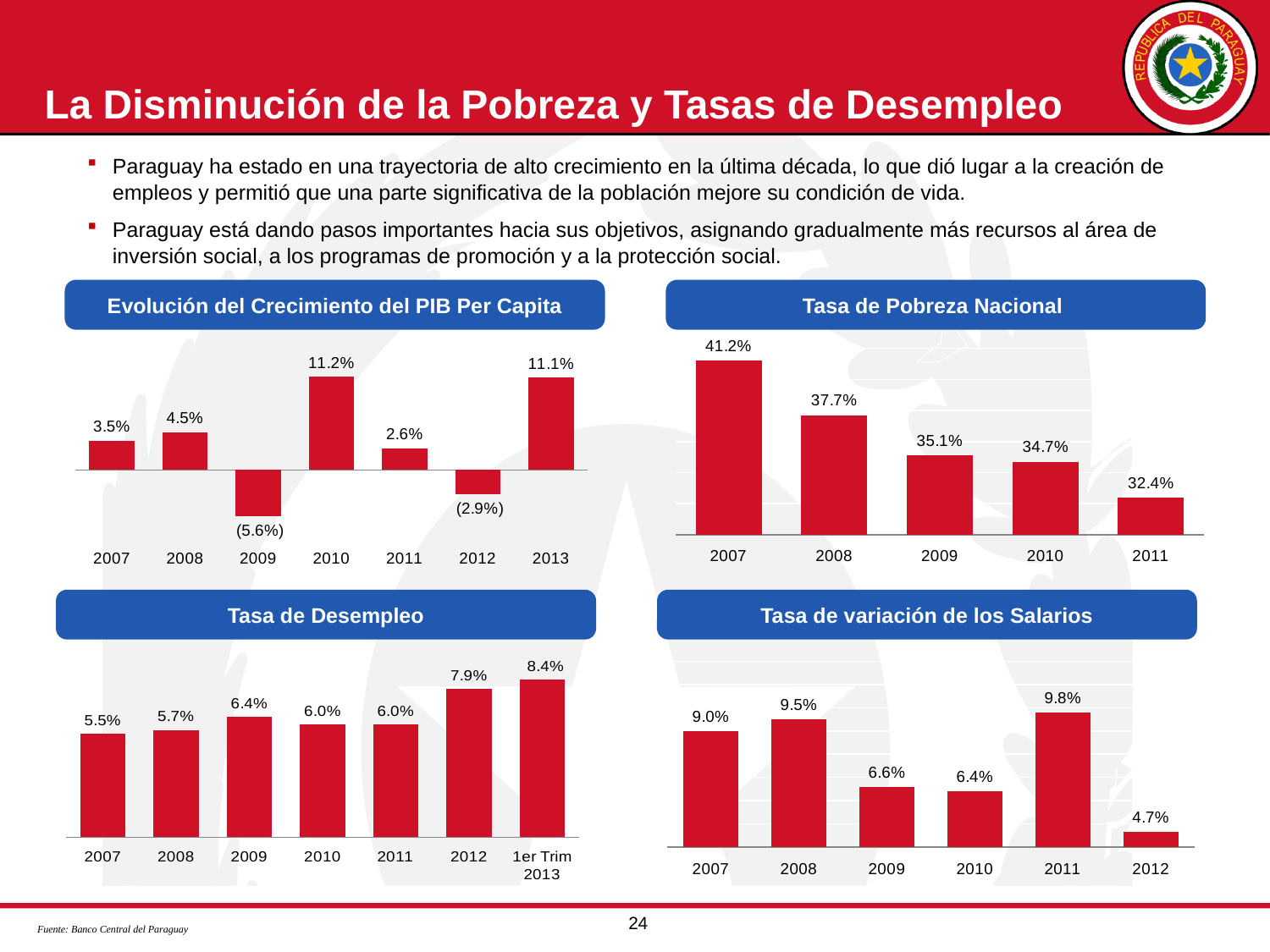
In the 'Tasa de Pobreza Nacional' chart, what is the difference between the 2007 and 2008 values? 3.5% In the 'Evolución del Crecimiento del PIB Per Capita' chart, what is the value for 2010? 11.2% In the 'Evolución del Crecimiento del PIB Per Capita' chart, how many years are shown on the x axis? 7 In the 'Tasa de Desempleo' chart, what is the value for 1er Trim 2013? 8.4% In the 'Tasa de Desempleo' chart, which year has the lowest value? 2007 In the 'Tasa de variación de los Salarios' chart, which year has the highest value? 2011 What kind of chart is the 'Tasa de variación de los Salarios' chart? bar chart In the 'Tasa de Pobreza Nacional' chart, what is the value for 2011? 32.4% In the 'Tasa de Pobreza Nacional' chart, do the values rise or fall from 2007 to 2011? fall In the 'Tasa de variación de los Salarios' chart, which is larger, the value for 2008 or the value for 2012? 2008 In the 'Evolución del Crecimiento del PIB Per Capita' chart, what is the value for 2009? (5.6%) In the 'Tasa de Pobreza Nacional' chart, which year has the highest value? 2007